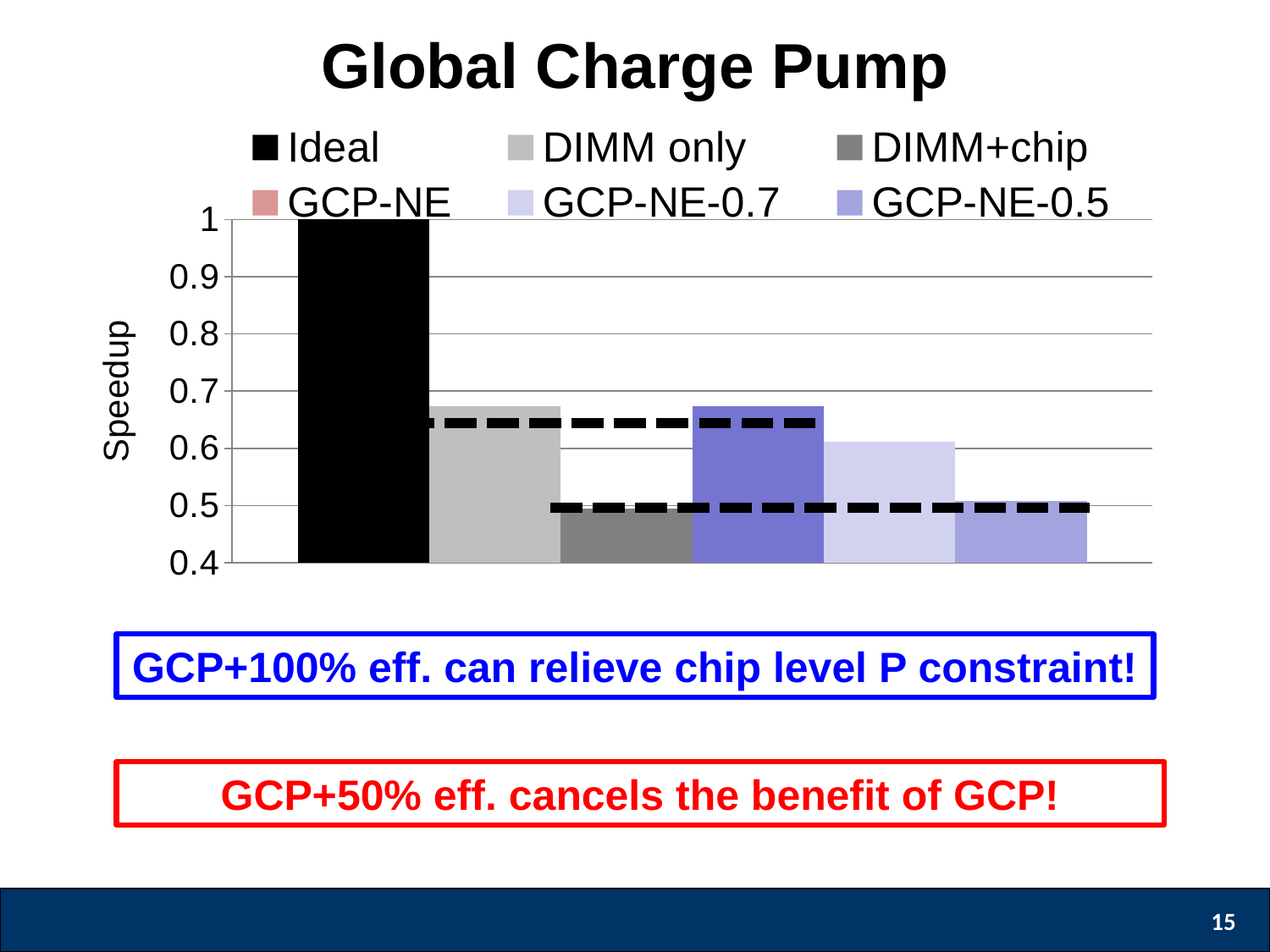
Is the value for DIMM+chip greater or less than 0.6? less What is the title of the chart? Global Charge Pump How many series does the legend list? 6 Which series has the highest speedup? Ideal What is the speedup value for Ideal? 1 What is the label on the vertical axis? Speedup What kind of chart is shown on the slide? bar chart Which is larger, the speedup for GCP-NE or for GCP-NE-0.5? GCP-NE Is the value for GCP-NE greater or less than 0.6? greater Is the value for DIMM only greater or less than 0.6? greater Which is larger, the speedup for DIMM only or for DIMM+chip? DIMM only